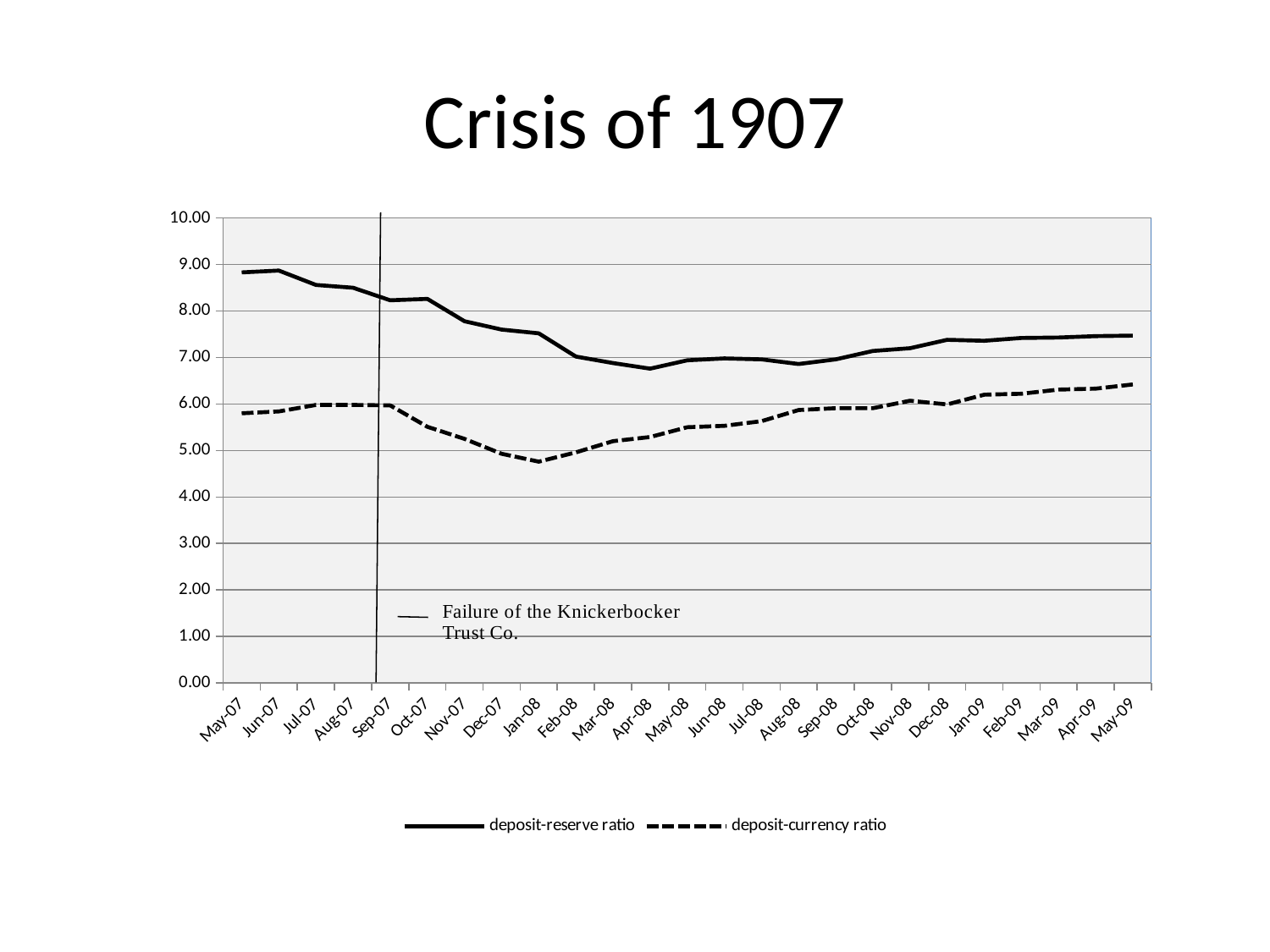
Which series is higher in Mar-08, the deposit-reserve ratio or the deposit-currency ratio? deposit-reserve ratio What kind of chart is shown on the slide? line chart Is the deposit-reserve ratio for May-07 greater or less than 8.00? greater In which month is the deposit-currency ratio at its lowest? Jan-08 How many series does the legend list? 2 Is the deposit-currency ratio for Jan-08 greater or less than 5.00? less In which month is the deposit-reserve ratio at its highest? Jun-07 Is the deposit-reserve ratio for Apr-08 greater or less than 7.00? less What event does the vertical line on the chart mark? Failure of the Knickerbocker Trust Co. How many monthly points are plotted along the x axis, from May-07 to May-09? 25 Does the deposit-reserve ratio rise or fall from May-07 to Apr-08? fall